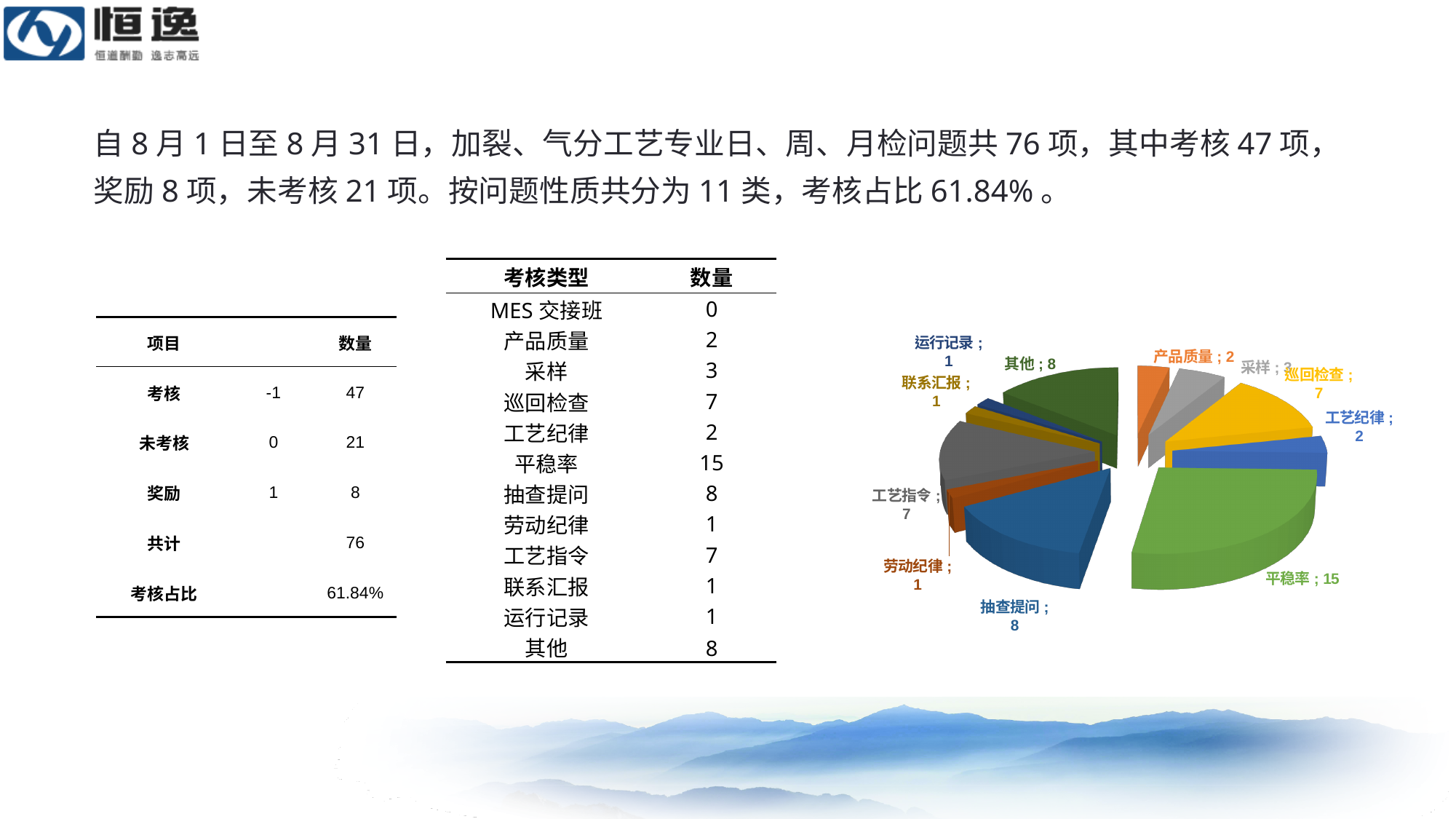
In the pie chart, what is the value for 巡回检查? 7 In the pie chart, what is the value for 采样? 3 In the pie chart, what is the value for 抽查提问? 8 What kind of chart is shown on the slide? pie chart In the pie chart, what is the value for 平稳率? 15 What is the difference between the values for 平稳率 and 抽查提问 in the pie chart? 7 How many labelled slices does the pie chart have? 11 Which category has the largest slice in the pie chart? 平稳率 In the pie chart, what is the value for 工艺纪律? 2 What is the difference between the values for 其他 and 产品质量 in the pie chart? 6 In the pie chart, which is larger: 巡回检查 or 采样? 巡回检查 What colour is the 平稳率 slice in the pie chart? green